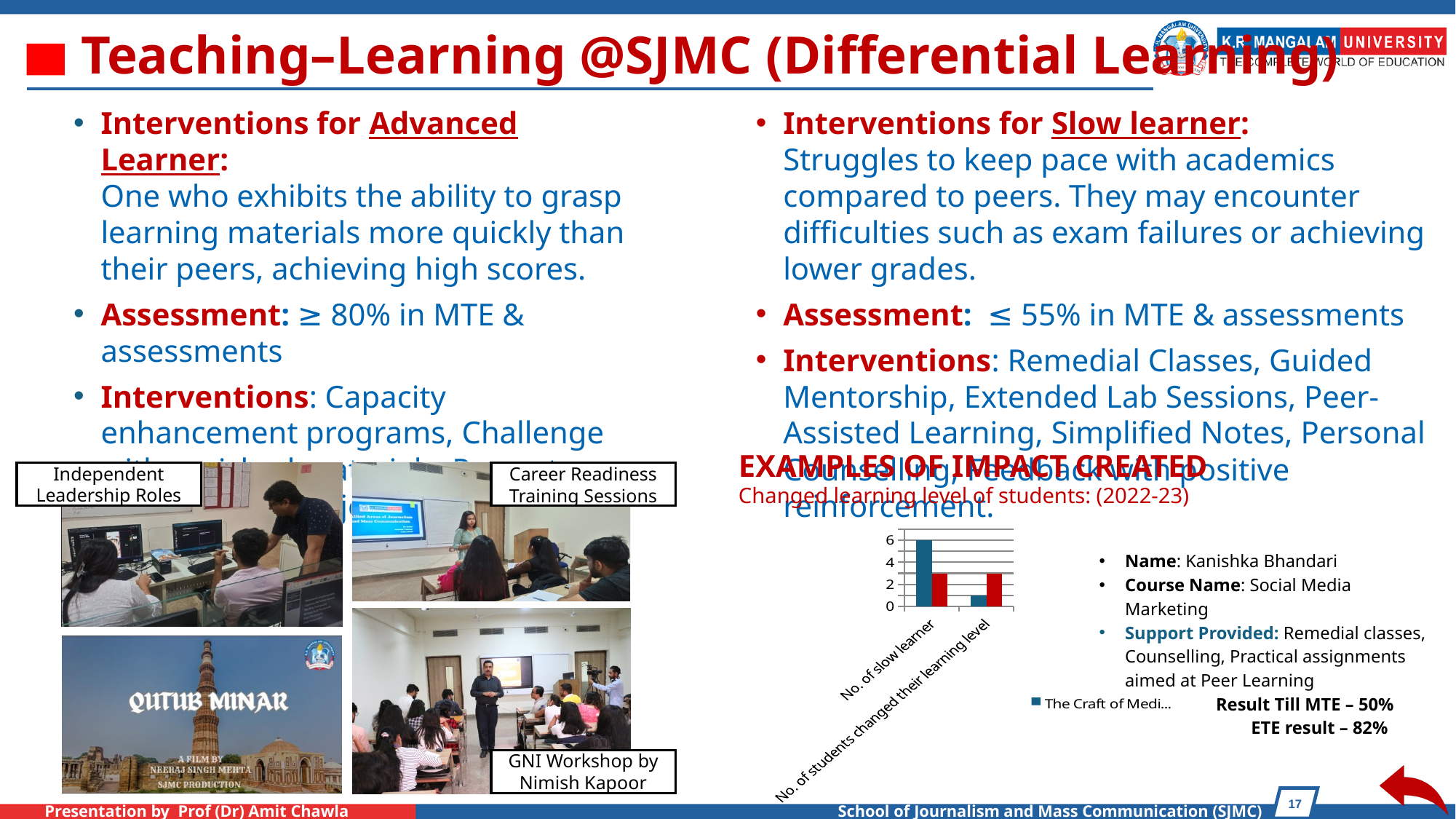
How many categories are shown on the x axis of the 'Changed learning level of students' chart? 2 What is the title printed above the bar chart on the slide? Changed learning level of students: (2022-23) In the 'Changed learning level of students' chart, is the blue bar larger for 'No. of slow learner' or for 'No. of students changed their learning level'? No. of slow learner What colour is the series labelled 'The Craft of Medi...' in the chart legend? blue In the 'Changed learning level of students' chart, is the blue bar for 'No. of slow learner' greater or less than 4? greater In the 'Changed learning level of students' chart, what is the value of the blue bar for 'No. of slow learner'? 6 In the 'Changed learning level of students' chart, does the blue series rise or fall from 'No. of slow learner' to 'No. of students changed their learning level'? fall In the 'Changed learning level of students' chart, which category has the tallest bar? No. of slow learner In the 'Changed learning level of students' chart, is the blue bar for 'No. of students changed their learning level' greater or less than 2? less What kind of chart is shown under 'Changed learning level of students: (2022-23)'? bar chart In the 'Changed learning level of students' chart, is the red bar for 'No. of slow learner' greater or less than 2? greater